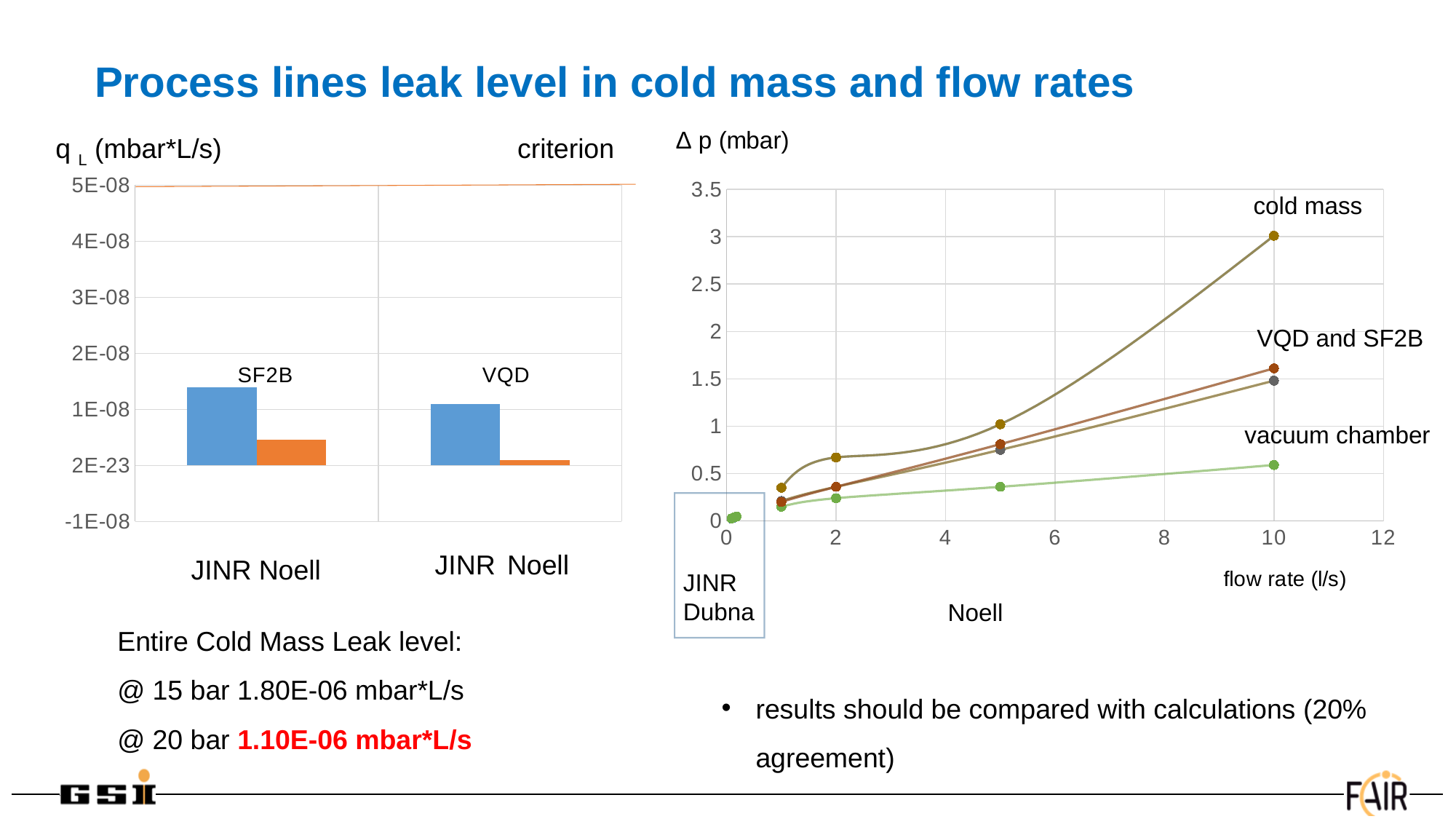
In the right chart, is the vacuum chamber value at a flow rate of 10 l/s greater or less than 1? less In the right chart, is the cold mass value at a flow rate of 10 l/s greater or less than 2.5? greater What kind of chart is the left chart (q L (mbar*L/s))? bar chart What kind of chart is the right chart (Δ p (mbar) versus flow rate)? line chart In the left chart, is the JINR bar for SF2B greater or less than 1E-08? greater In the left chart, which is larger: the JINR bar for SF2B or the JINR bar for VQD? JINR bar for SF2B In the right chart, which series has the highest Δ p at a flow rate of 10 l/s? cold mass In the right chart, which series has the lowest Δ p at a flow rate of 10 l/s? vacuum chamber In the left chart, at what value is the criterion line drawn? 5E-08 In the right chart, does the cold mass Δ p rise or fall as the flow rate increases? rises In the left chart, how many labelled bar groups are there? 2